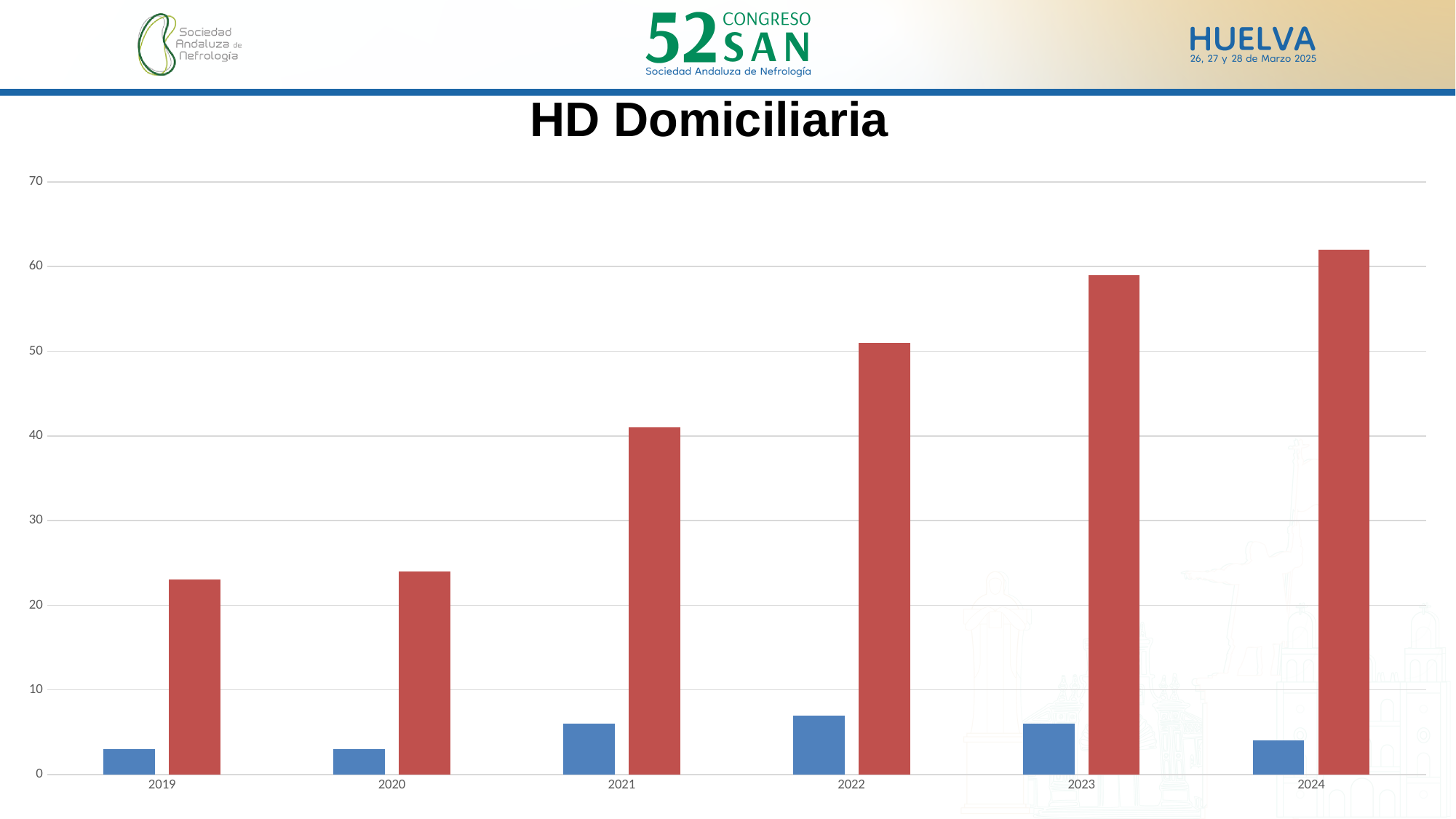
Is the red bar for 2022 greater or less than 40? greater In 2021, which bar is taller, the blue bar or the red bar? the red bar Do the red bars rise or fall from 2019 to 2024? rise Is the red bar for 2019 greater or less than 30? less Which is larger, the red bar for 2024 or the red bar for 2019? the red bar for 2024 Which year has the tallest red bar? 2024 What is the title of the chart? HD Domiciliaria Is the red bar for 2024 greater or less than 50? greater How many years are shown on the x axis of the chart? 6 What kind of chart is shown on the slide? bar chart